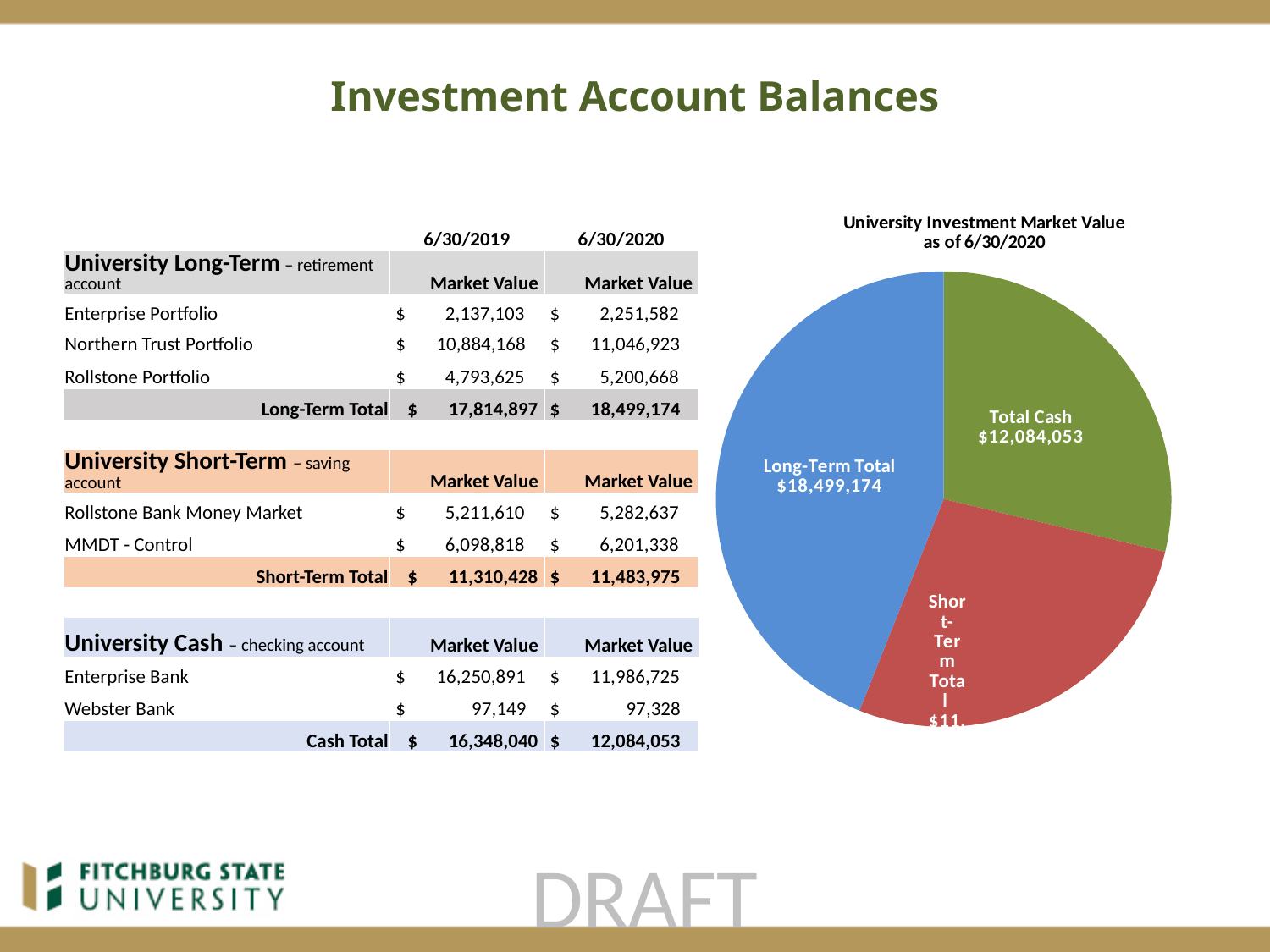
What is the title of the pie chart? University Investment Market Value as of 6/30/2020 What value is shown for the Total Cash slice in the pie chart? $12,084,053 What value is shown for the Long-Term Total slice in the pie chart? $18,499,174 What kind of chart is shown on the slide? pie chart In the pie chart, which is larger: Long-Term Total or Total Cash? Long-Term Total In the pie chart, how much larger is the Long-Term Total than the Total Cash? $6,415,121 How many slices does the pie chart have? 3 What colour is the Long-Term Total slice in the pie chart? blue Which slice of the pie chart is the largest? Long-Term Total